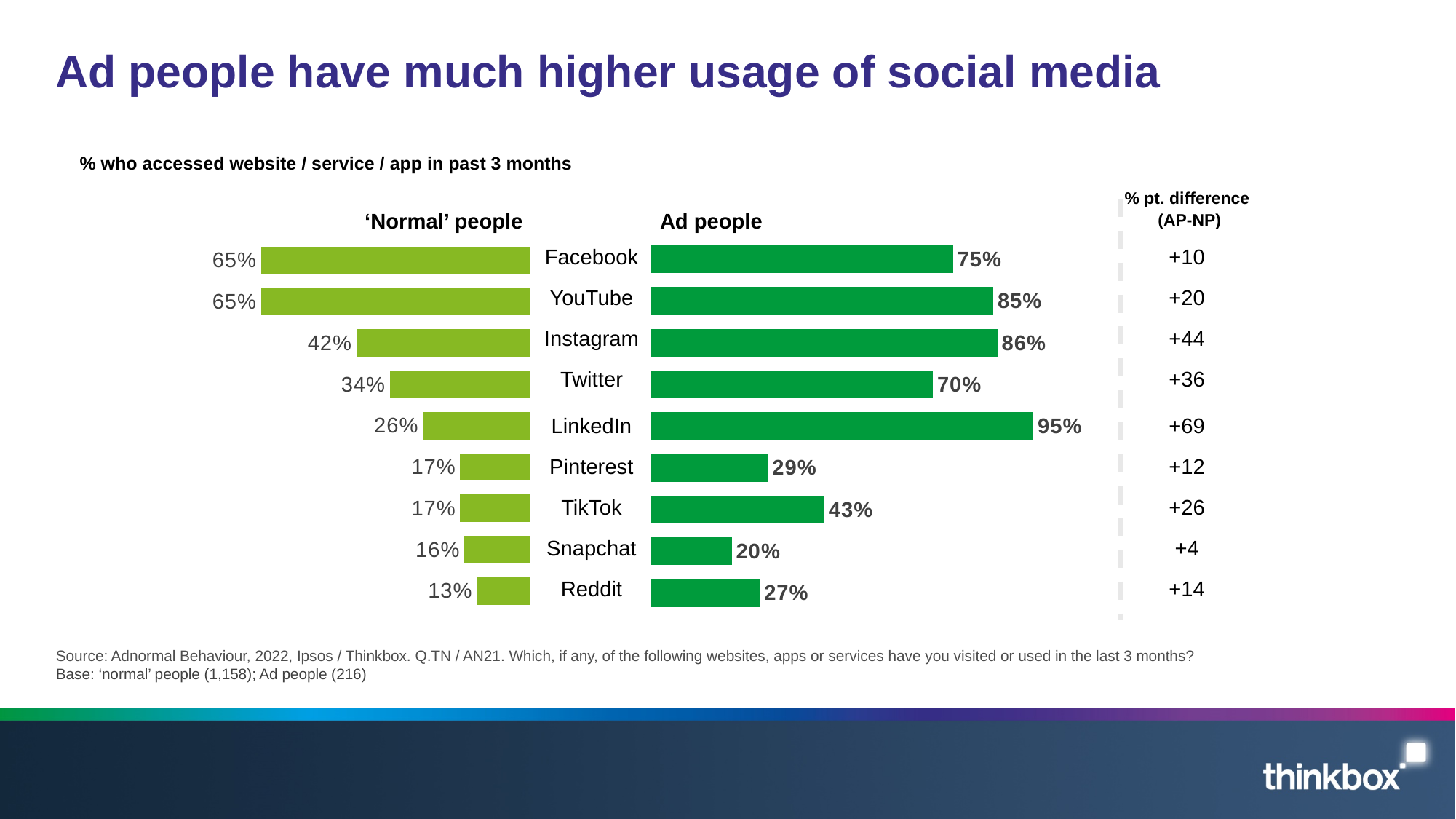
Which is larger: the Ad people value for Pinterest or the Ad people value for Reddit? Pinterest Which platform has the highest value among Ad people? LinkedIn What is the difference between the Ad people and 'Normal' people values for TikTok? 26 percentage points Which platform has the largest percentage point difference between Ad people and 'Normal' people? LinkedIn Which platform has the lowest value among Ad people? Snapchat What is the subtitle describing the measure plotted in the chart? % who accessed website / service / app in past 3 months What percentage of Ad people accessed LinkedIn in the past 3 months? 95% Which platform has the lowest value among 'Normal' people? Reddit What is the percentage point difference between Ad people and 'Normal' people for Twitter? +36 How many platforms are shown in the chart? 9 What kind of chart is shown on the slide? Bar chart What percentage of 'Normal' people accessed Instagram in the past 3 months? 42%